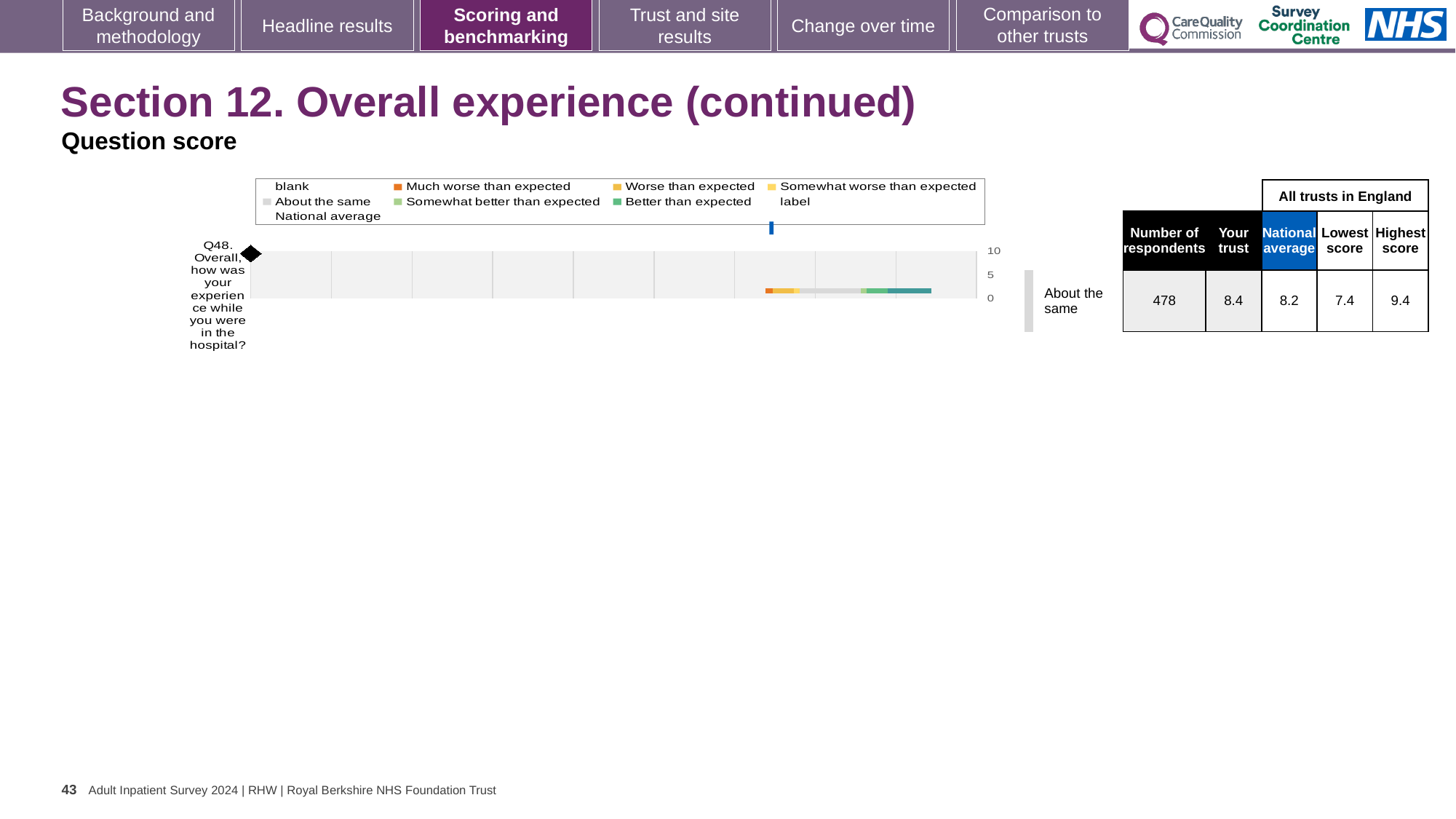
Which question is plotted in the chart? Q48. Overall, how was your experience while you were in the hospital? How many questions (categories) are plotted in the chart? 1 What kind of chart is shown on the slide? bar chart In the table next to the chart, what is the number of respondents for Q48? 478 What is the highest tick value shown on the chart's score axis? 10 In the table next to the chart, what is the highest score among all trusts in England for Q48? 9.4 What is the difference between the highest score and the lowest score for Q48? 2.0 Which is larger for Q48: the 'Your trust' score or the national average? Your trust In the table next to the chart, what is the lowest score among all trusts in England for Q48? 7.4 What benchmarking category is Q48 assigned to on the slide? About the same In the table next to the chart, what is the 'Your trust' score for Q48? 8.4 In the table next to the chart, what is the national average score for Q48? 8.2